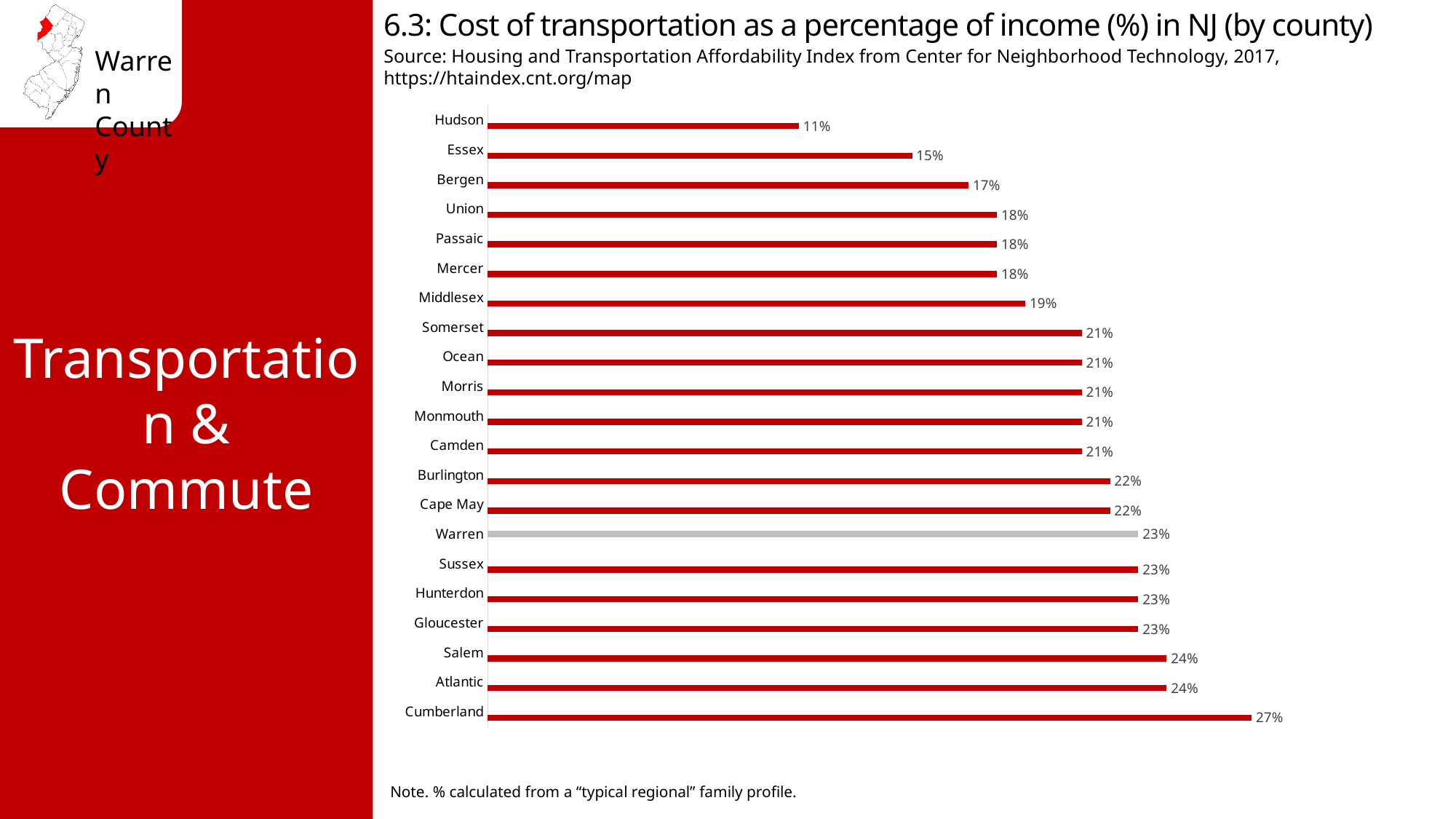
Which county has the lowest cost of transportation as a percentage of income? Hudson What is the cost of transportation as a percentage of income for Warren County? 23% What is the difference between the values for Warren and Essex? 8% Which has a larger value, Bergen or Salem? Salem Which county's bar is shown in grey rather than red? Warren What is the difference between the values for Cumberland and Hudson? 16% What is the value shown for Hudson County? 11% What is the value shown for Middlesex County? 19% What is the title of the chart? 6.3: Cost of transportation as a percentage of income (%) in NJ (by county) How many counties are shown in the chart? 21 What kind of chart is shown on the slide? Bar chart Which county has the highest cost of transportation as a percentage of income? Cumberland